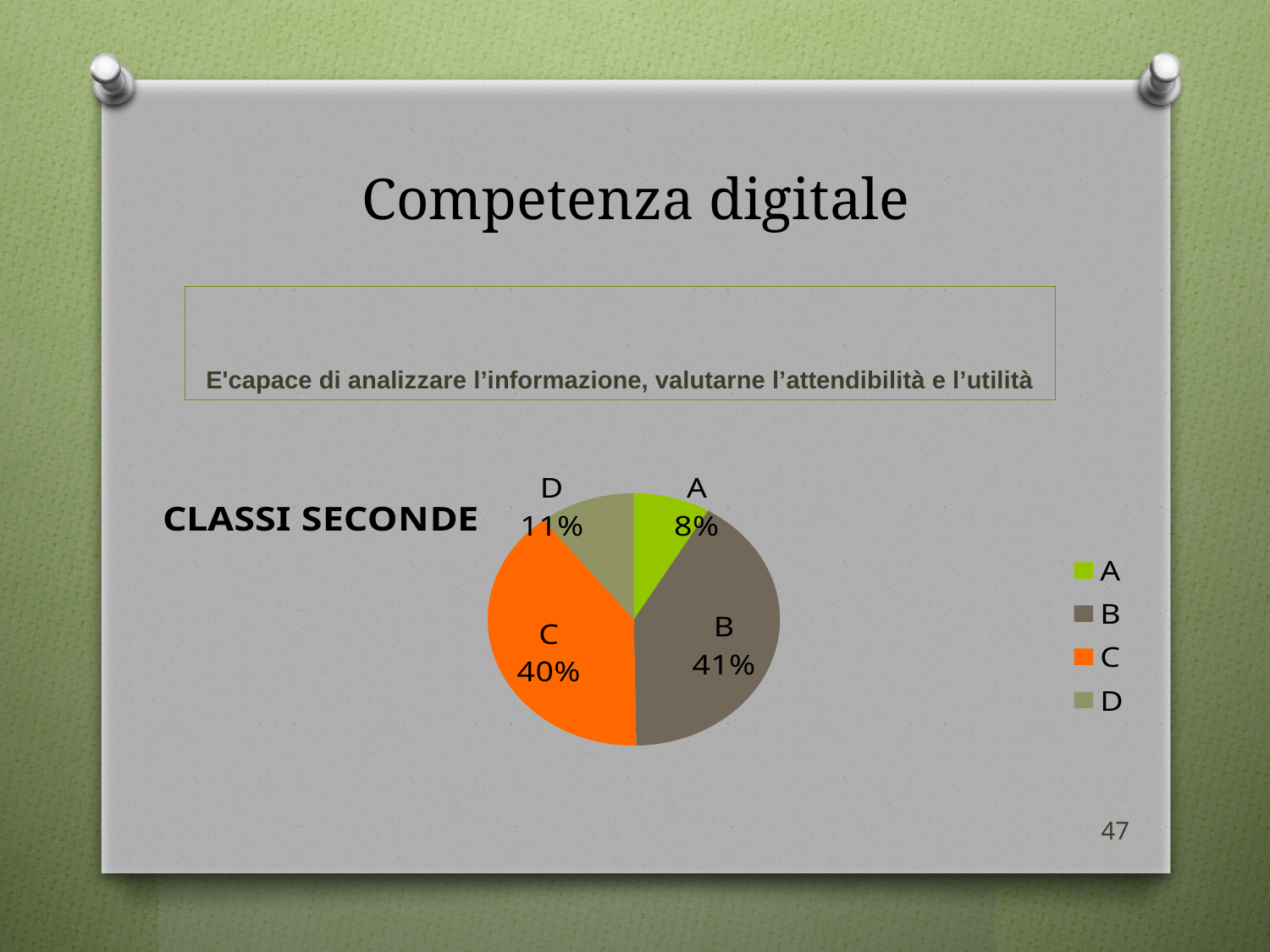
What is the difference between the percentages for B and A? 33% What is the difference between the percentages for C and D? 29% What label appears to the left of the pie chart? CLASSI SECONDE Which category has the smallest slice in the pie chart? A What percentage does slice C represent in the pie chart? 40% Which is larger, the slice for D or the slice for A? D Which category has the largest slice in the pie chart? B What is the share of slice A in the pie chart? 8% How many slices does the pie chart have? 4 What kind of chart is shown on the slide? pie chart What percentage does slice B represent in the pie chart? 41% What percentage does slice D represent in the pie chart? 11%